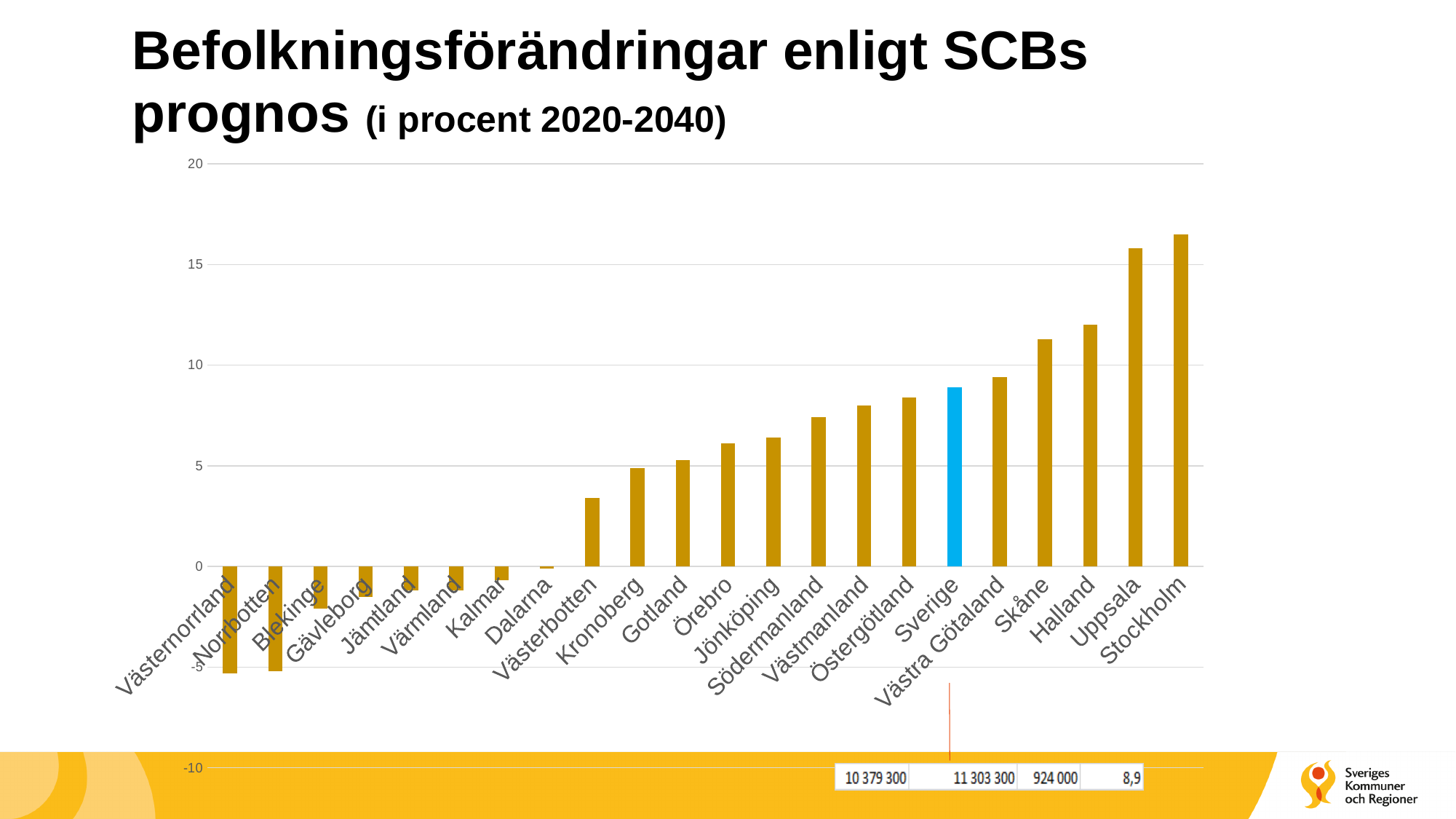
How many categories are plotted on the x axis of the chart? 22 Is the value for Västerbotten greater or less than 5? less Which has the larger value, Uppsala or Halland? Uppsala Which category's bar is coloured blue instead of gold? Sverige Which has the larger value, Örebro or Gotland? Örebro Is the value for Stockholm greater or less than 15? greater Do the values generally rise or fall moving from left to right along the x axis? rise What kind of chart is shown on the slide? bar chart Is the value for Blekinge greater or less than 0? less Which category has the highest value in the chart? Stockholm